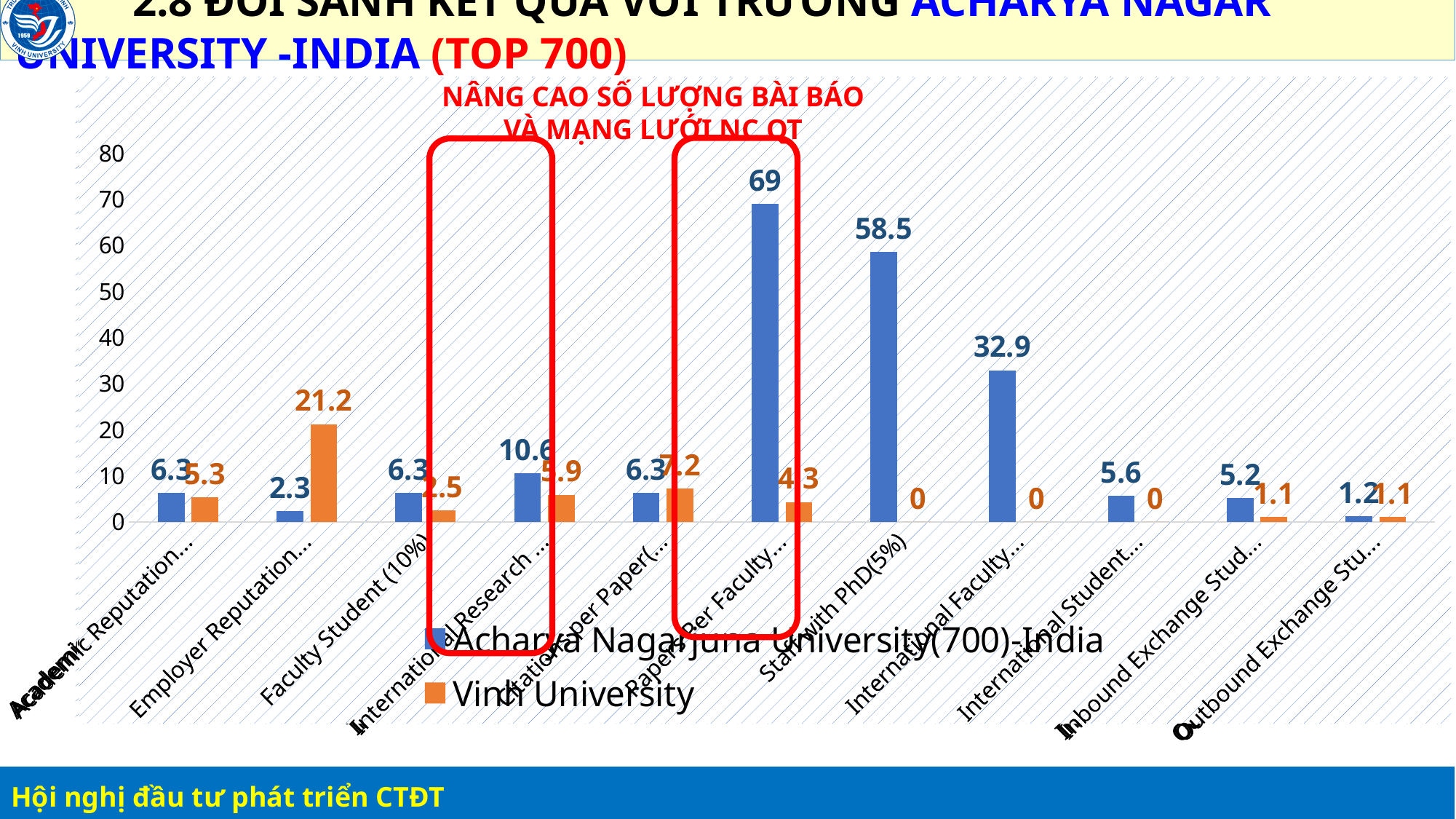
What kind of chart is shown on the slide? bar chart What is the difference between the two universities' values in the Staff with PhD(5%) category? 58.5 In which category does Vinh University have its highest value? Employer Reputation What is the value for Vinh University in the Faculty Student (10%) category? 2.5 How many series does the chart legend list? 2 How many categories are plotted along the x axis of the chart? 11 What is the difference between Acharya Nagarjuna University's and Vinh University's values in the Faculty Student (10%) category? 3.8 What is the value for Acharya Nagarjuna University (700)-India in the Staff with PhD(5%) category? 58.5 Which colour represents Vinh University in the chart? orange What is the value for Vinh University in the Employer Reputation category? 21.2 Which university has the larger value in the Employer Reputation category? Vinh University In which category does Acharya Nagarjuna University (700)-India have its highest value? Papers Per Faculty